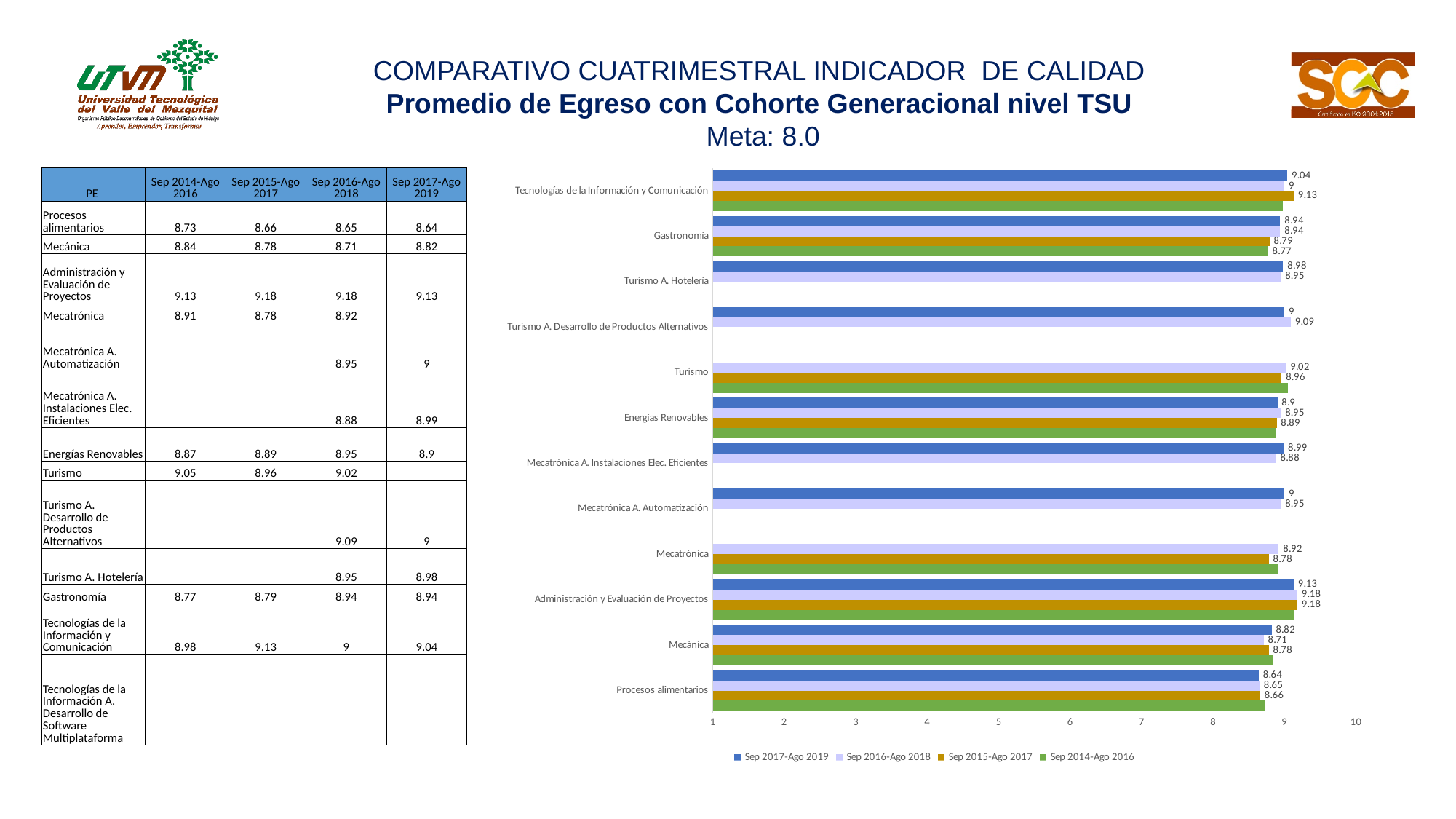
Which category has the highest value in the Sep 2016-Ago 2018 series? Administración y Evaluación de Proyectos What is the value for Turismo A. Desarrollo de Productos Alternativos in the Sep 2016-Ago 2018 series? 9.09 What is the difference between the Sep 2017-Ago 2019 and Sep 2015-Ago 2017 values for Gastronomía? 0.15 Which colour represents the Sep 2014-Ago 2016 series in the chart legend? green Is the Sep 2014-Ago 2016 value for Procesos alimentarios greater or less than 8? greater What kind of chart is shown on the slide? bar chart What is the value for Procesos alimentarios in the Sep 2015-Ago 2017 series? 8.66 How many series does the chart legend list? 4 How many categories (programas educativos) are plotted on the chart? 12 What is the value for Tecnologías de la Información y Comunicación in the Sep 2017-Ago 2019 series? 9.04 For Mecánica, which is larger: the Sep 2017-Ago 2019 value or the Sep 2016-Ago 2018 value? Sep 2017-Ago 2019 Which category has the lowest value in the Sep 2017-Ago 2019 series? Procesos alimentarios